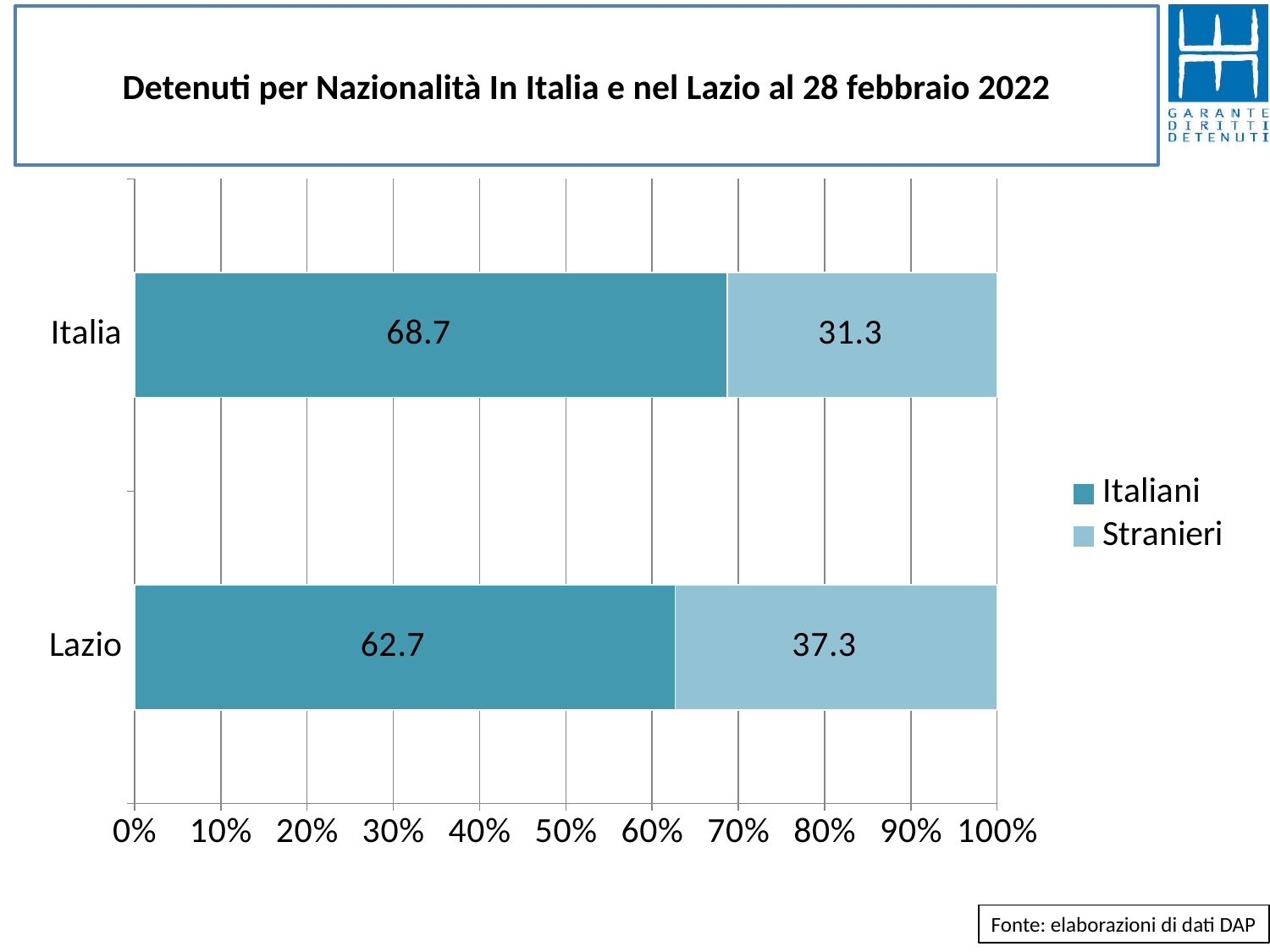
What is the title of the chart? Detenuti per Nazionalità In Italia e nel Lazio al 28 febbraio 2022 What is the value for Stranieri in Italia? 31.3 What is the value for Italiani in Lazio? 62.7 Which category has the higher value for Stranieri, Italia or Lazio? Lazio What is the value for Italiani in Italia? 68.7 What is the difference between the Italiani values for Italia and Lazio? 6.0 What is the value for Stranieri in Lazio? 37.3 How many series does the legend list? 2 What is the difference between the Stranieri values for Lazio and Italia? 6.0 What kind of chart is shown on the slide? Stacked bar chart Which category has the higher value for Italiani, Italia or Lazio? Italia How many categories are shown on the chart? 2